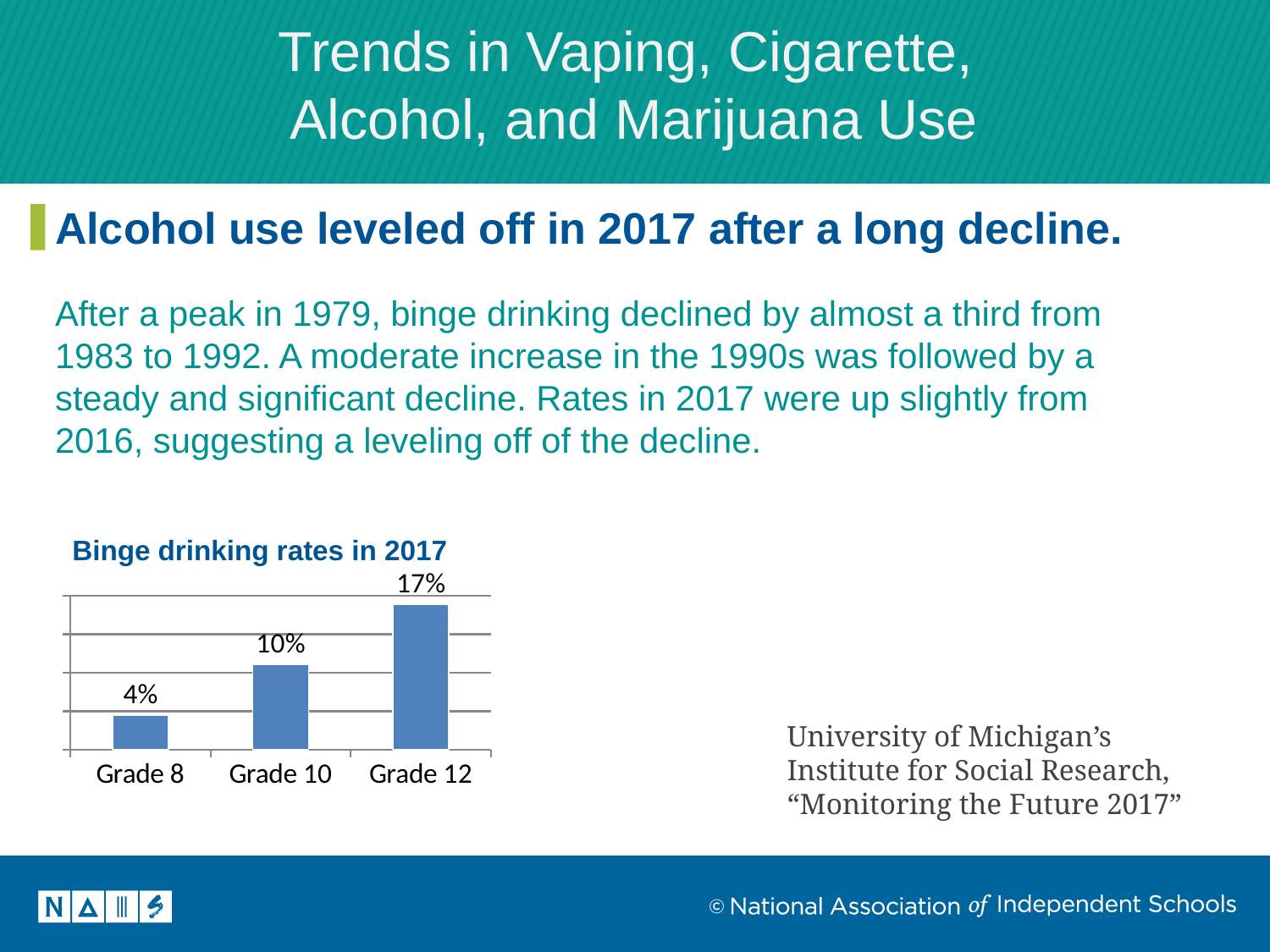
What is the binge drinking rate for Grade 10? 10% What is the difference between the binge drinking rates for Grade 10 and Grade 8? 6% What is the difference between the binge drinking rates for Grade 12 and Grade 8? 13% Which has a higher binge drinking rate, Grade 10 or Grade 12? Grade 12 What is the title of the chart? Binge drinking rates in 2017 What kind of chart is shown on the slide? Bar chart Which grade has the lowest binge drinking rate? Grade 8 Which grade has the highest binge drinking rate? Grade 12 What is the binge drinking rate for Grade 12? 17% How many grades are shown in the chart? 3 Do the binge drinking rates rise or fall from Grade 8 to Grade 12? Rise What is the binge drinking rate for Grade 8? 4%